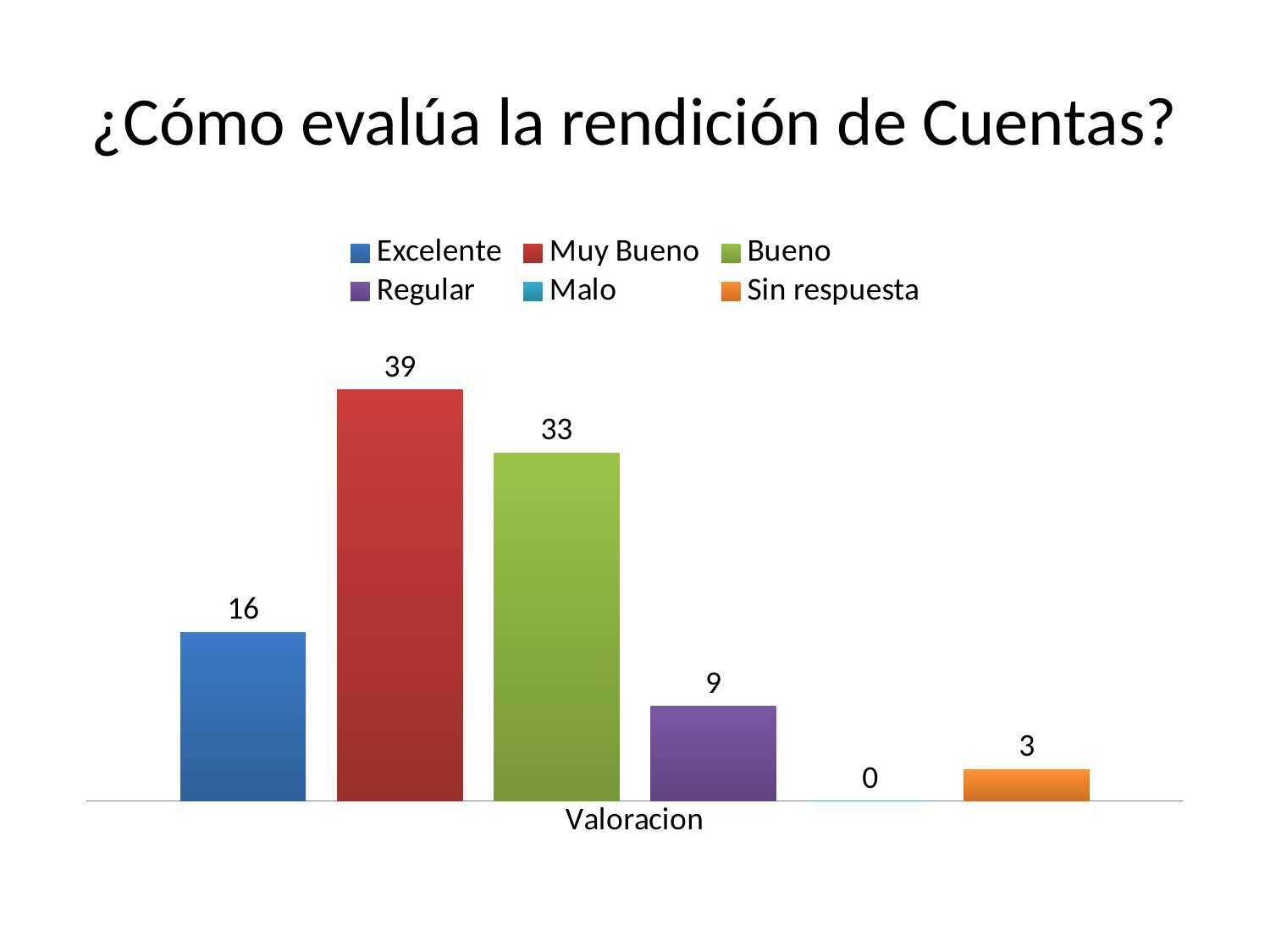
Which is larger, the value for Excelente or the value for Regular? Excelente What is the difference between the values for Muy Bueno and Bueno? 6 How many series does the legend list? 6 What is the title of the chart? ¿Cómo evalúa la rendición de Cuentas? What kind of chart is shown on the slide? bar chart What is the value for Malo? 0 What is the value for Muy Bueno? 39 What is the value for Excelente? 16 Which series has the highest value? Muy Bueno Which series has the lowest value? Malo What is the label on the x axis? Valoracion What is the value for Sin respuesta? 3